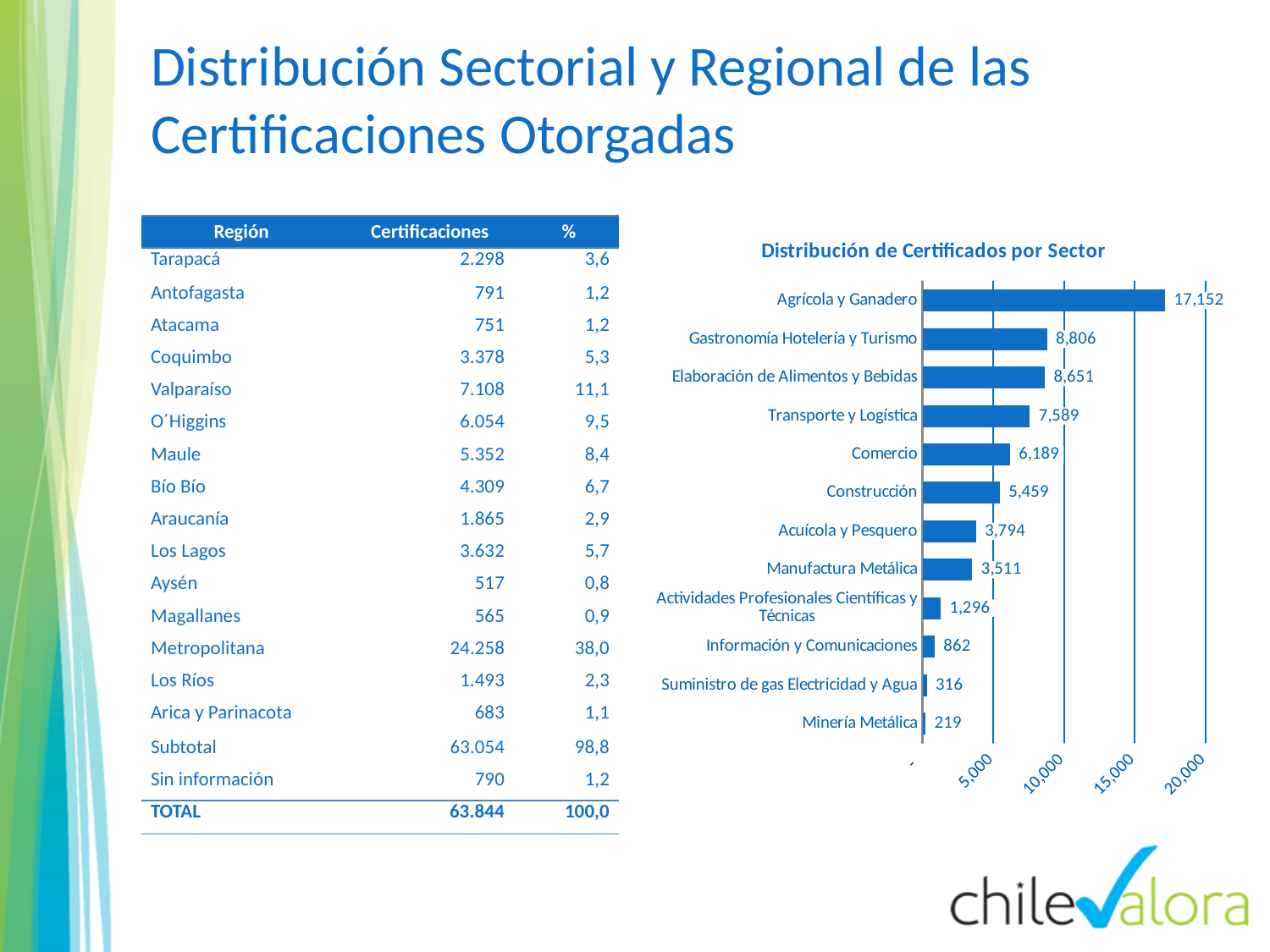
What is the value for Transporte y Logística in the chart? 7,589 What is the value for Agrícola y Ganadero in the Distribución de Certificados por Sector chart? 17,152 What is the difference between the values for Comercio and Construcción? 730 Is the value for Transporte y Logística greater or less than 5,000? greater What is the value for Minería Metálica in the chart? 219 What is the difference between the values for Agrícola y Ganadero and Gastronomía Hotelería y Turismo? 8,346 What kind of chart is Distribución de Certificados por Sector? Bar chart What is the value for Actividades Profesionales Científicas y Técnicas in the chart? 1,296 How many sectors are shown in the Distribución de Certificados por Sector chart? 12 Which sector has the highest number of certificados in the chart? Agrícola y Ganadero Which is larger in the chart, Gastronomía Hotelería y Turismo or Elaboración de Alimentos y Bebidas? Gastronomía Hotelería y Turismo Which sector has the lowest number of certificados in the chart? Minería Metálica